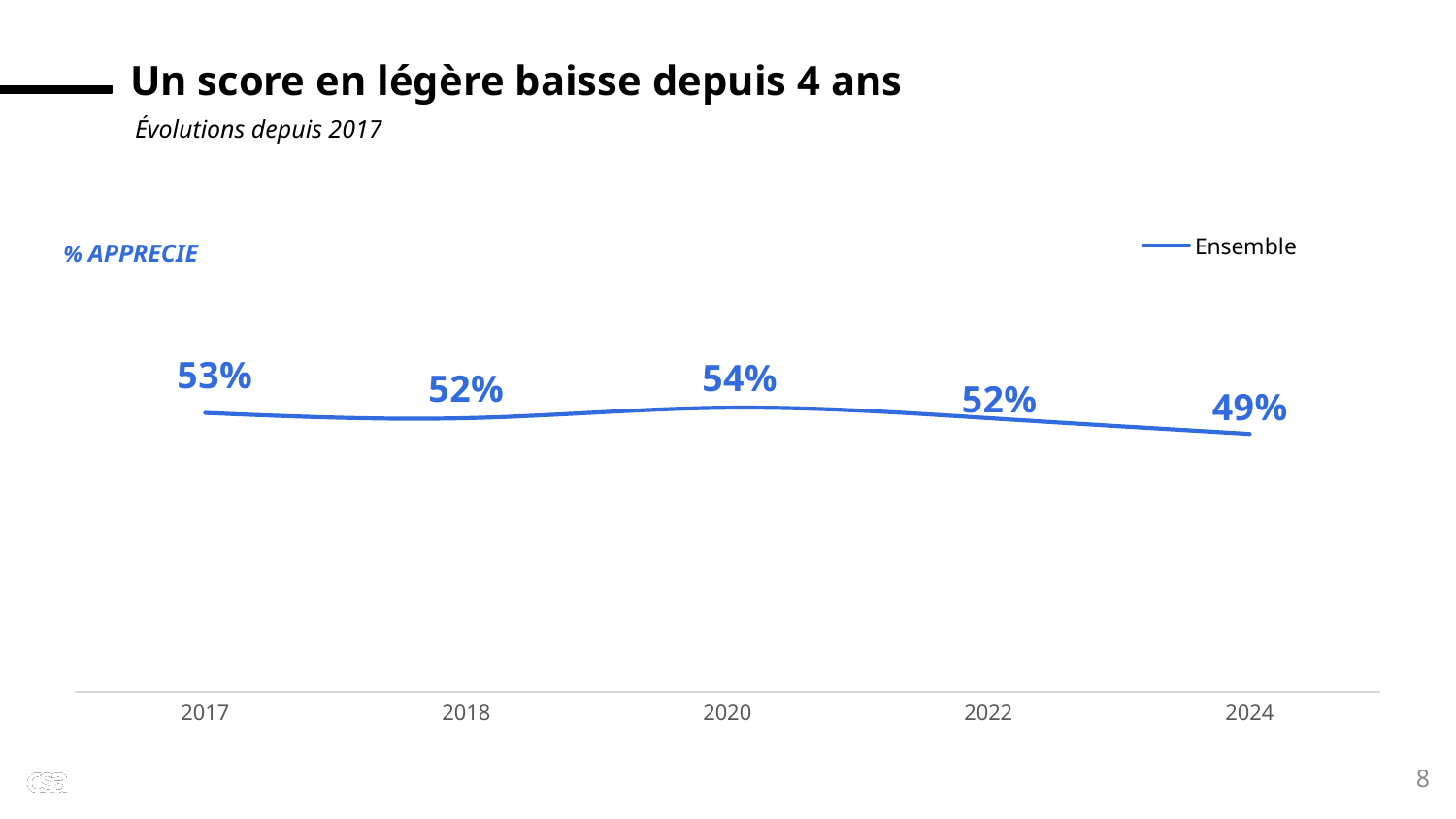
How many years are plotted on the chart? 5 What is the value for 2020? 54% Which year has the lowest value? 2024 What is the value for 2022? 52% What is the value for 2017? 53% How many series does the legend list? 1 What kind of chart is shown? line chart What is the value for 2024? 49% What is the name of the series shown in the legend? Ensemble What is the difference between the values for 2020 and 2024? 5% Which year has the highest value? 2020 Which is larger, the value for 2017 or the value for 2024? 2017